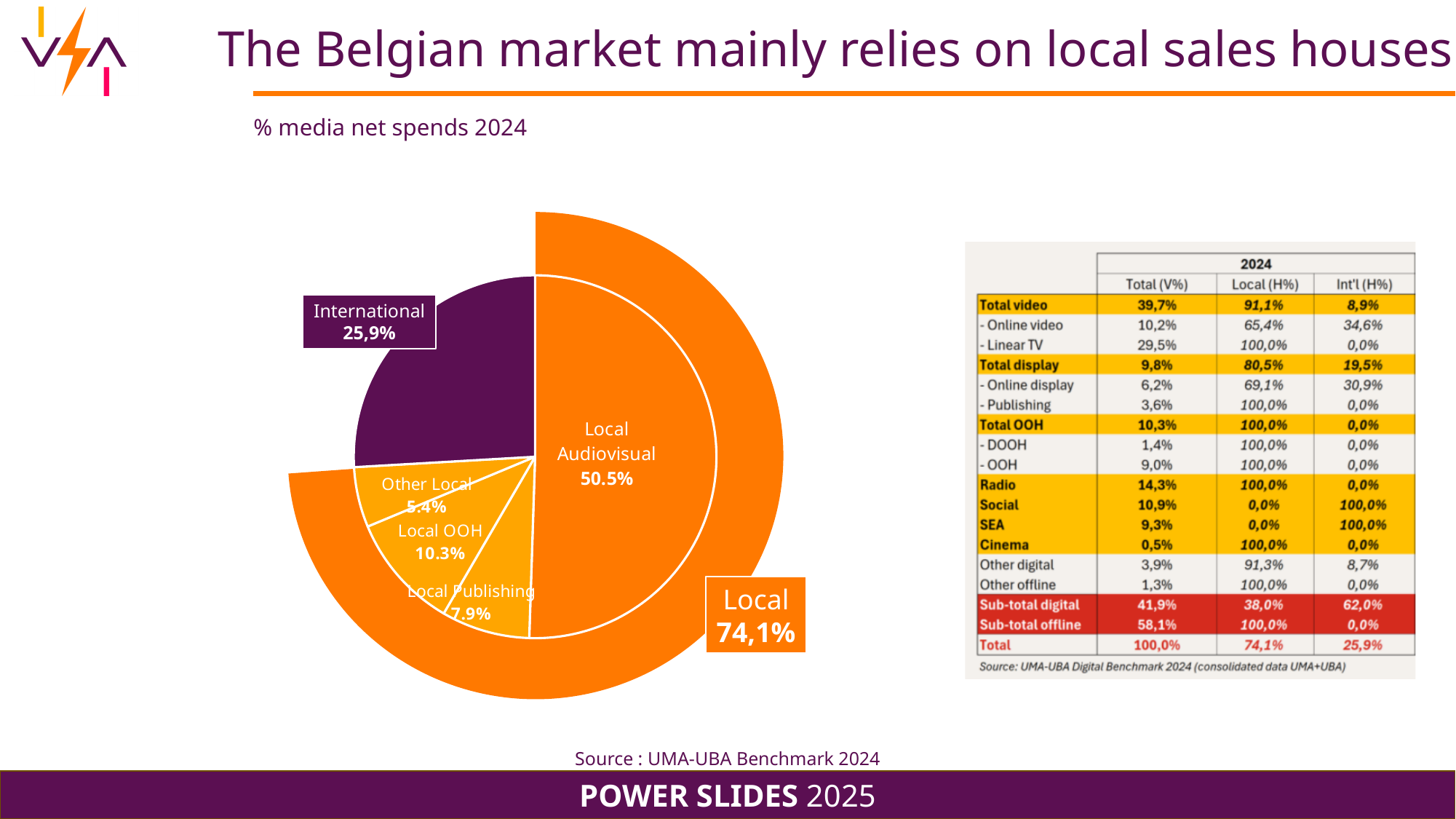
Which is larger in the pie chart, Local OOH or Local Publishing? Local OOH What total share does the outer ring label give for Local in the pie chart? 74,1% Which slice of the pie chart is the smallest? Other Local What is the difference between Local Audiovisual and International in the pie chart? 24.6% Which slice of the pie chart is the largest? Local Audiovisual What is the value for Other Local in the pie chart? 5.4% What is the value for Local OOH in the pie chart? 10.3% How many slices does the pie chart have? 5 What is the value for International in the pie chart? 25,9% What kind of chart is shown on the left of the slide? Pie chart What is the value for Local Publishing in the pie chart? 7.9% What is the value for Local Audiovisual in the pie chart? 50.5%